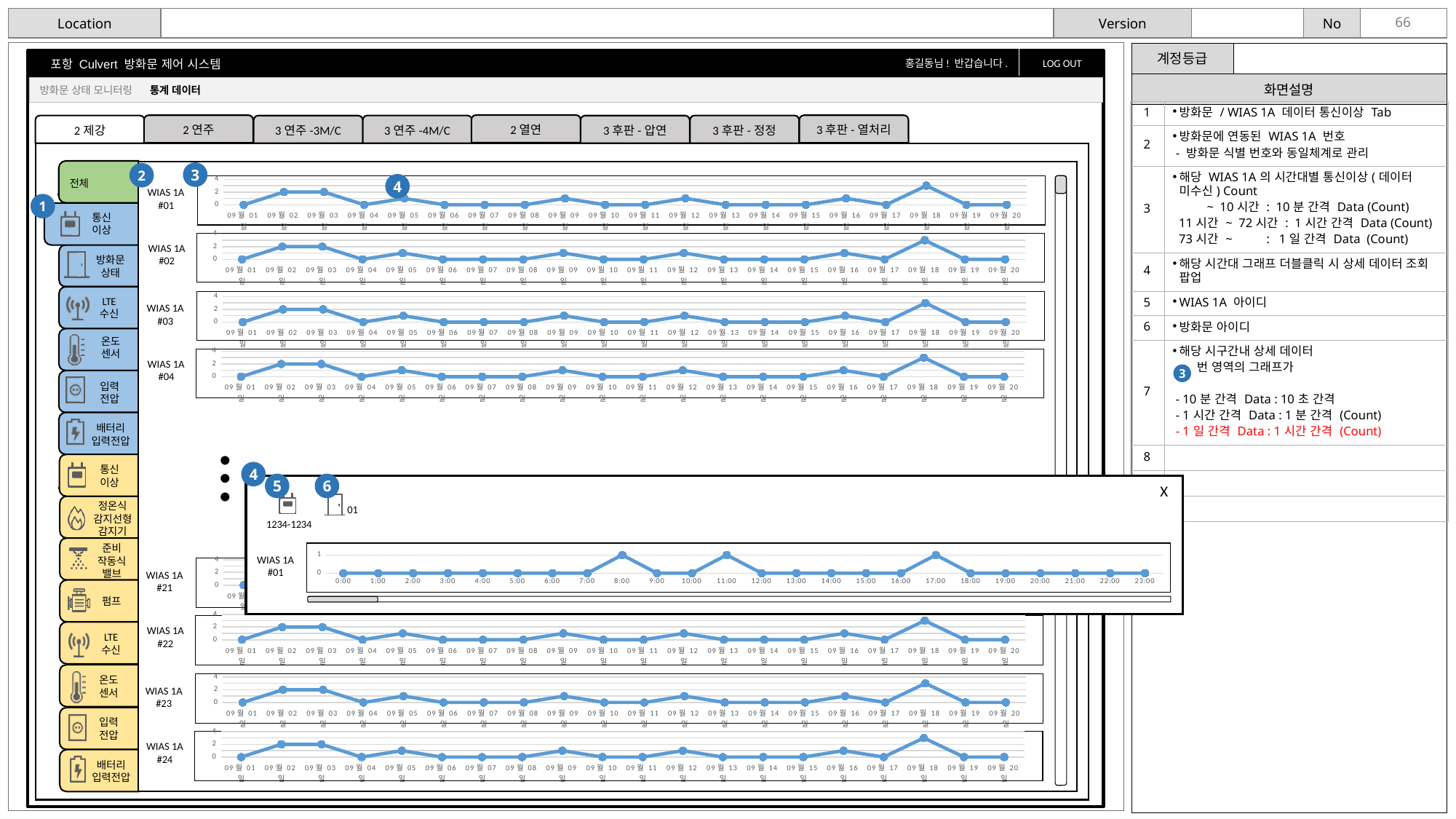
In the popup chart for WIAS 1A #01 (x axis 0:00 to 23:00), how many data points are plotted? 24 In the WIAS 1A #24 chart at the bottom of the slide, which is larger, the value for 09월 18일 or the value for 09월 19일? 09월 18일 In the WIAS 1A #01 chart at the top of the slide, is the value for 09월 01일 greater or less than 2? less In the popup chart for WIAS 1A #01 (x axis 0:00 to 23:00), what is the difference between the value at 8:00 and the value at 9:00? 1 In the popup chart for WIAS 1A #01 (x axis 0:00 to 23:00), what is the value at 0:00? 0 In the popup chart for WIAS 1A #01 (x axis 0:00 to 23:00), what is the value at 17:00? 1 In the WIAS 1A #01 chart at the top of the slide, which date has the highest value? 09월 18일 In the popup chart for WIAS 1A #01 (x axis 0:00 to 23:00), what is the value at 8:00? 1 In the WIAS 1A #01 chart at the top of the slide, how many dates are shown on the x axis? 20 In the popup chart for WIAS 1A #01 (x axis 0:00 to 23:00), which is larger, the value at 11:00 or the value at 12:00? 11:00 In the WIAS 1A #01 chart at the top of the slide, is the value for 09월 18일 greater or less than 2? greater What kind of chart is the WIAS 1A #01 chart at the top of the slide? line chart